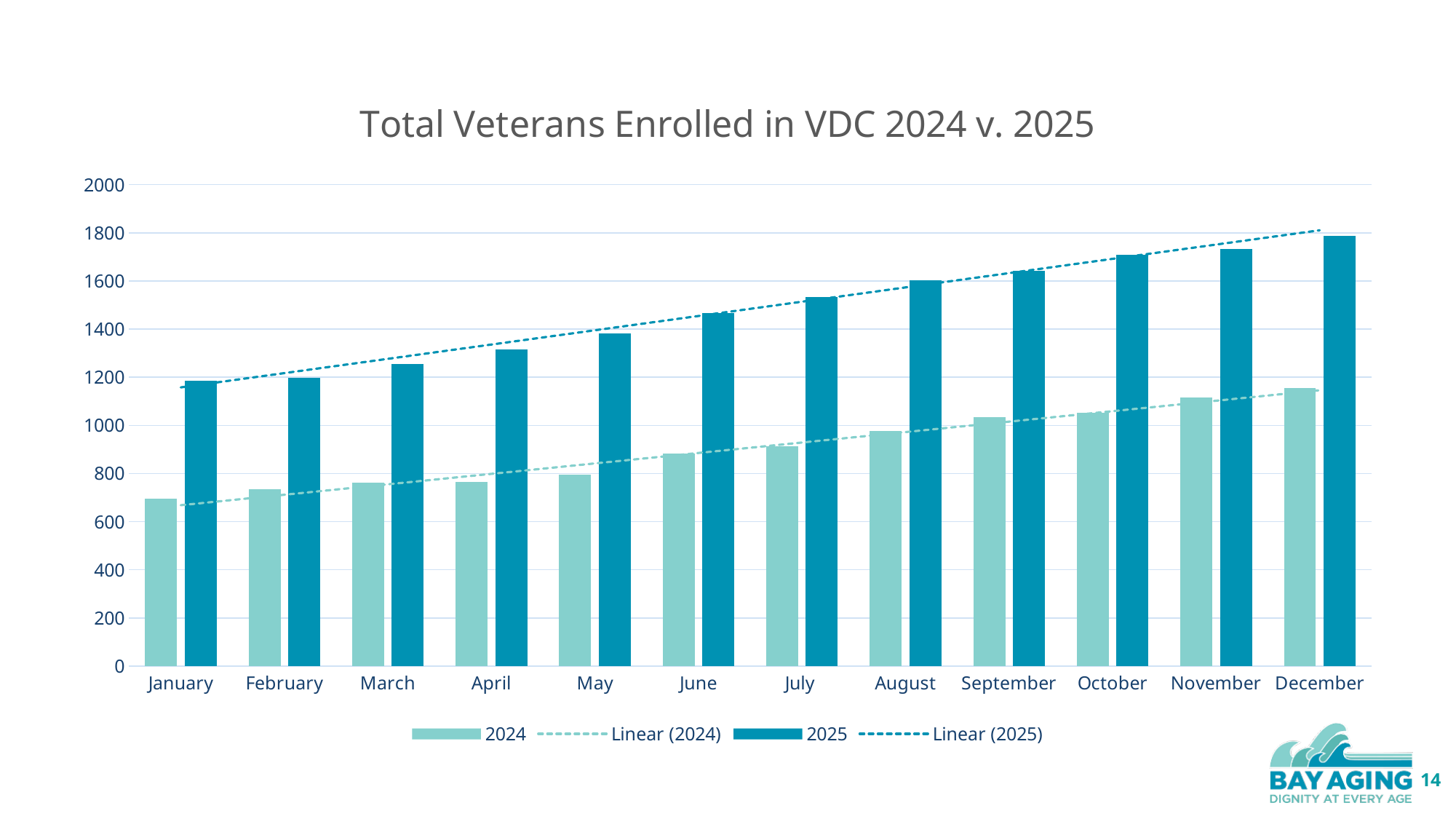
Which is larger, the value for June 2025 or the value for December 2024? June 2025 Which month has the highest value for the 2025 series? December Is the value for September 2024 greater or less than 1000? greater What kind of chart is shown on the slide? bar chart Is the value for June 2025 greater or less than 1400? greater How many months are shown on the x axis? 12 Is the value for January 2024 greater or less than 800? less Which month has the lowest value for the 2024 series? January How many entries does the legend list? 4 What is the title of the chart? Total Veterans Enrolled in VDC 2024 v. 2025 Do the 2025 values rise or fall from January to December? rise